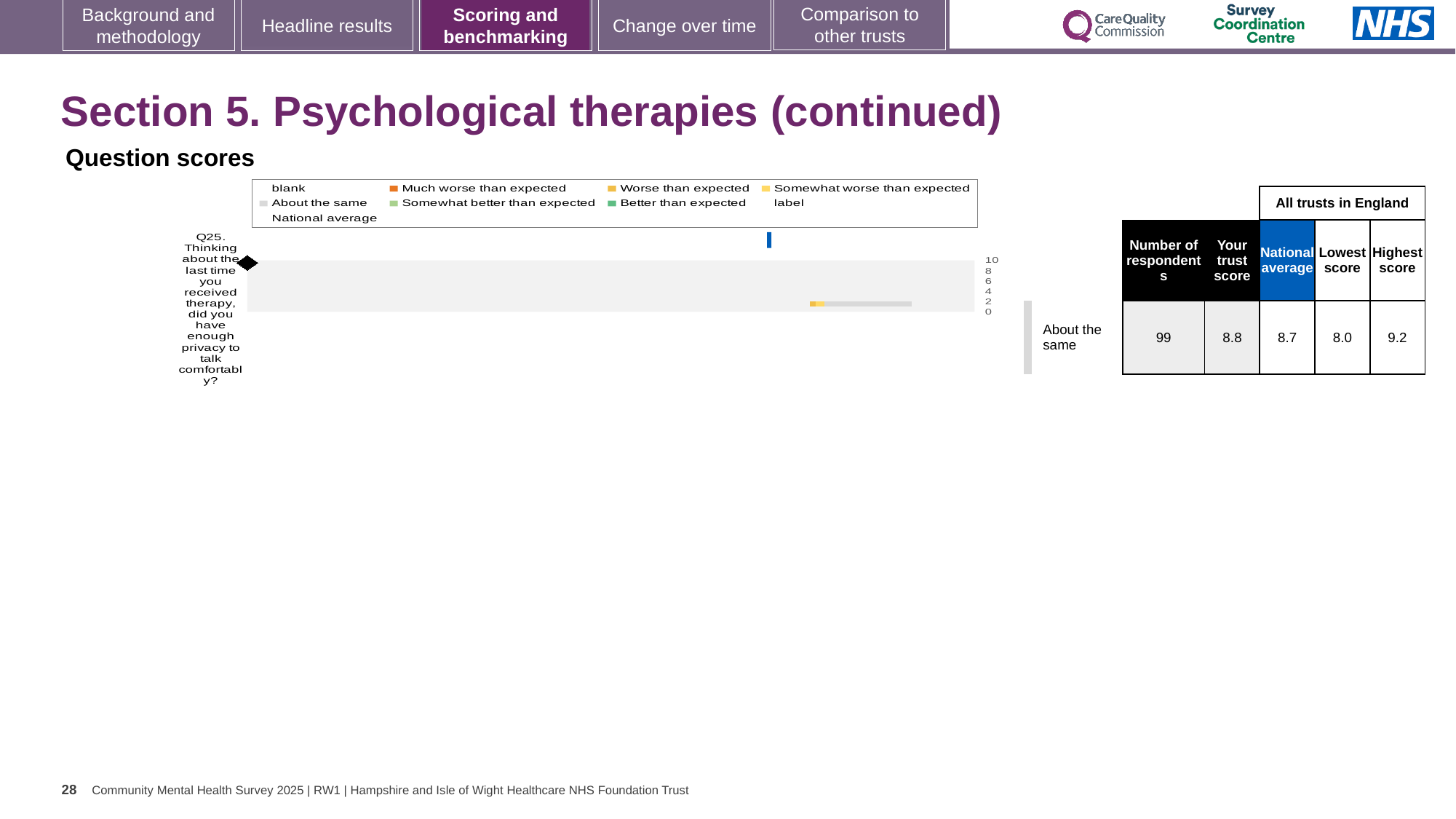
How many questions (categories) are plotted on the chart? 1 What is the trust's score for Q25 shown in the table next to the chart? 8.8 What is the lowest score among all trusts in England for Q25? 8.0 What kind of chart is shown under 'Question scores'? bar chart What is the national average score for Q25? 8.7 What is the difference between the highest and lowest scores for Q25 across all trusts in England? 1.2 How many respondents answered Q25? 99 How is the trust's Q25 result categorised relative to expectations? About the same What is the difference between the trust's score and the lowest score for Q25? 0.8 Which question number is plotted on the chart? Q25 What is the highest score among all trusts in England for Q25? 9.2 Which is larger for Q25, the trust's score or the national average? Your trust score